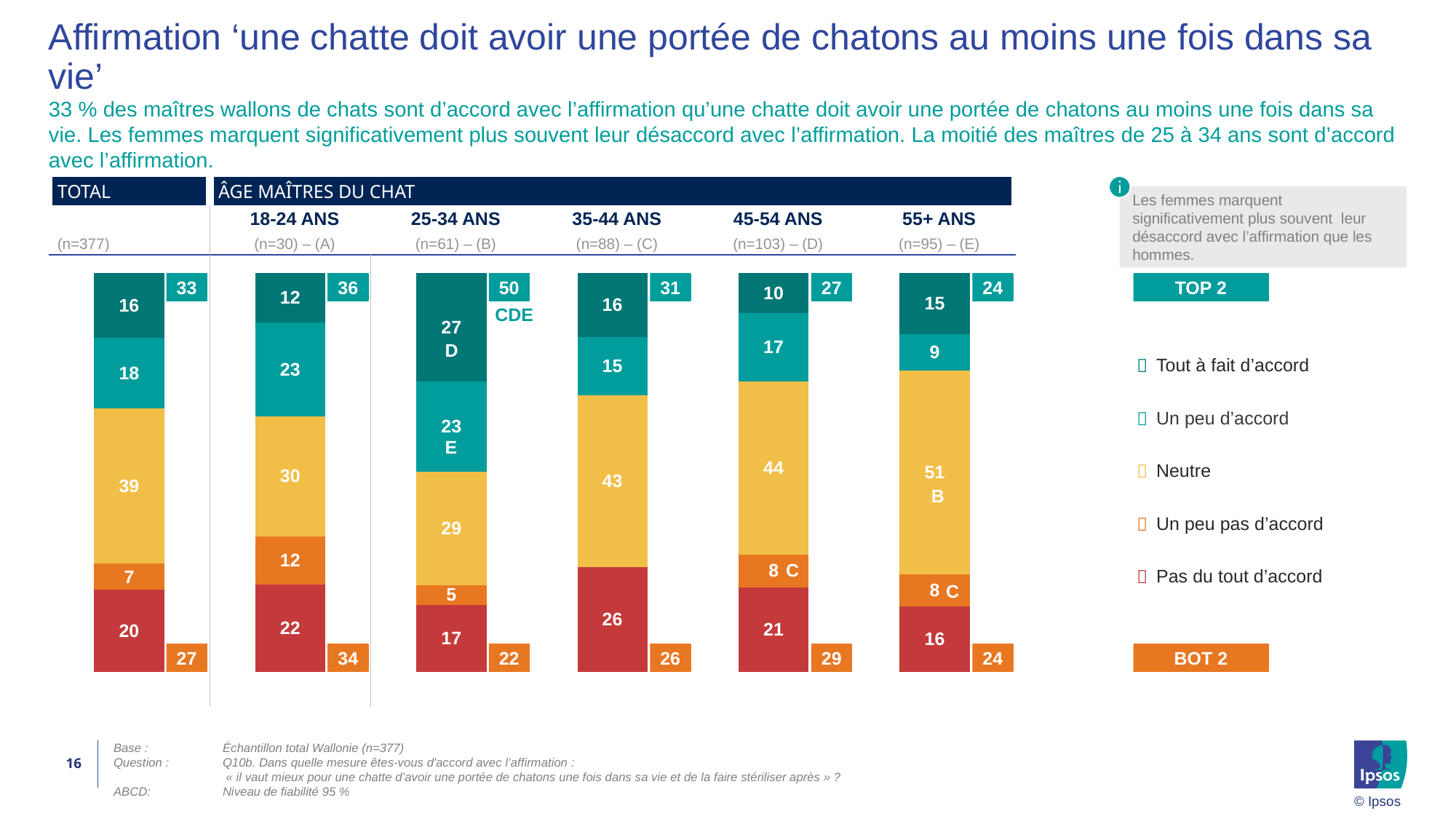
What is the TOP 2 value for the 25-34 ANS group? 50 How many response categories does the legend list? 5 Which age group has the lowest 'Tout à fait d'accord' value? 45-54 ANS What kind of chart is shown on the slide? Stacked bar chart What is the BOT 2 value for the 18-24 ANS group? 34 What is the sample size (n) for the 45-54 ANS group? 103 Which is larger: the 'Neutre' value for 55+ ANS or the 'Neutre' value for 18-24 ANS? 55+ ANS What is the 'Neutre' value for the TOTAL bar? 39 How many age groups are shown in the chart, excluding TOTAL? 5 What is the difference between the TOP 2 value for 25-34 ANS and the TOP 2 value for 55+ ANS? 26 Which age group has the highest TOP 2 value? 25-34 ANS What is the 'Pas du tout d'accord' value for the 35-44 ANS group? 26